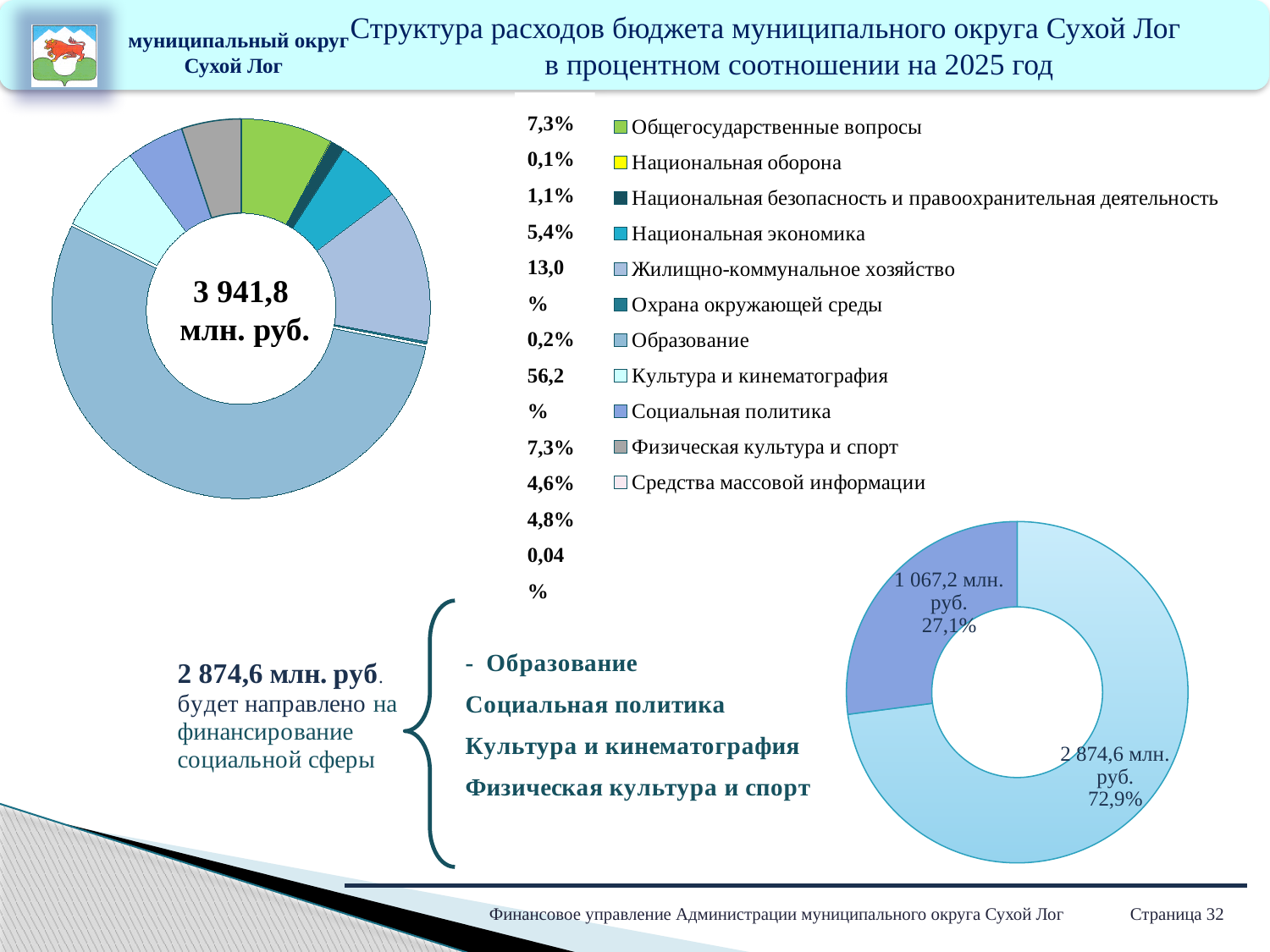
How many categories does the legend of the large chart on the left list? 11 In the large chart on the left, which is larger: the share for Жилищно-коммунальное хозяйство or the share for Общегосударственные вопросы? Жилищно-коммунальное хозяйство In the small chart at the bottom right, what value and share are shown for the larger slice? 2 874,6 млн. руб., 72,9% In the small chart at the bottom right, what share does the smaller slice have? 27,1% In the large chart on the left, what percentage is shown for Образование? 56,2% In the large chart on the left, what percentage is shown for Жилищно-коммунальное хозяйство? 13,0% In the large chart on the left, which category has the smallest share, Средства массовой информации or Национальная оборона? Средства массовой информации In the large chart on the left, what total value is printed in the centre of the doughnut? 3 941,8 млн. руб. What kind of chart is the large chart on the left of the slide? Doughnut (pie) chart In the large chart on the left, what percentage is shown for Национальная экономика? 5,4% In the small chart at the bottom right, what is the difference in percentage points between the two slices? 45,8 In the large chart on the left, which category has the largest share of the budget? Образование